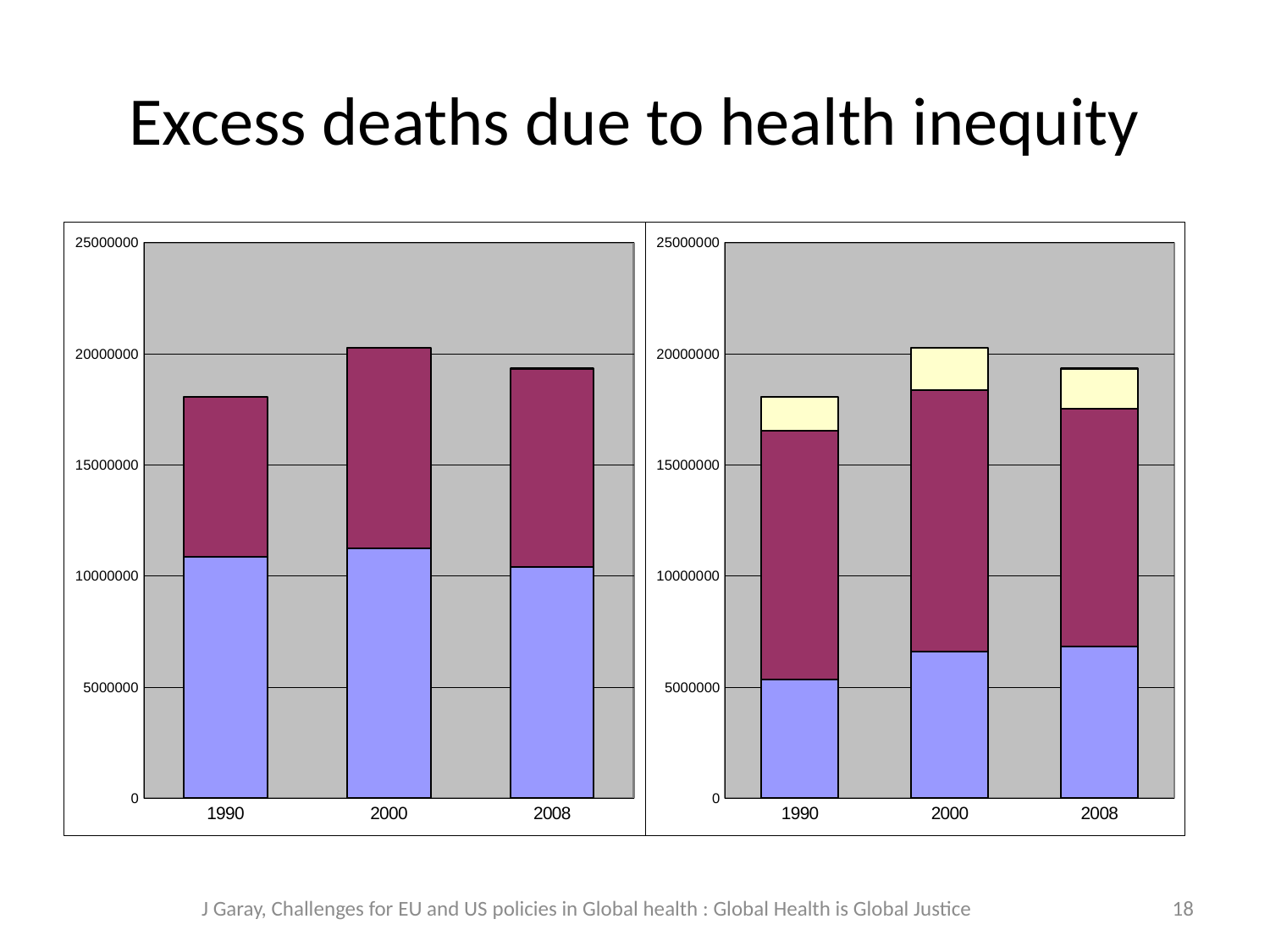
In the right chart, which year has the tallest bar? 2000 In the left chart, is the total for 1990 greater or less than 20000000? less In the right chart, is the bottom (blue) segment for 2000 greater or less than 5000000? greater In the right chart, which year has the shortest bar? 1990 In the right chart, is the total for 2008 greater or less than 20000000? less In the left chart, which year has the shortest bar? 1990 How many categories are shown on the x axis of the left chart? 3 What type of chart is the left chart on the slide? stacked bar chart How many stacked segments (colours) does each bar in the right chart have? 3 In the left chart, which year has the tallest bar? 2000 In the left chart, does the total rise or fall from 1990 to 2000? rise